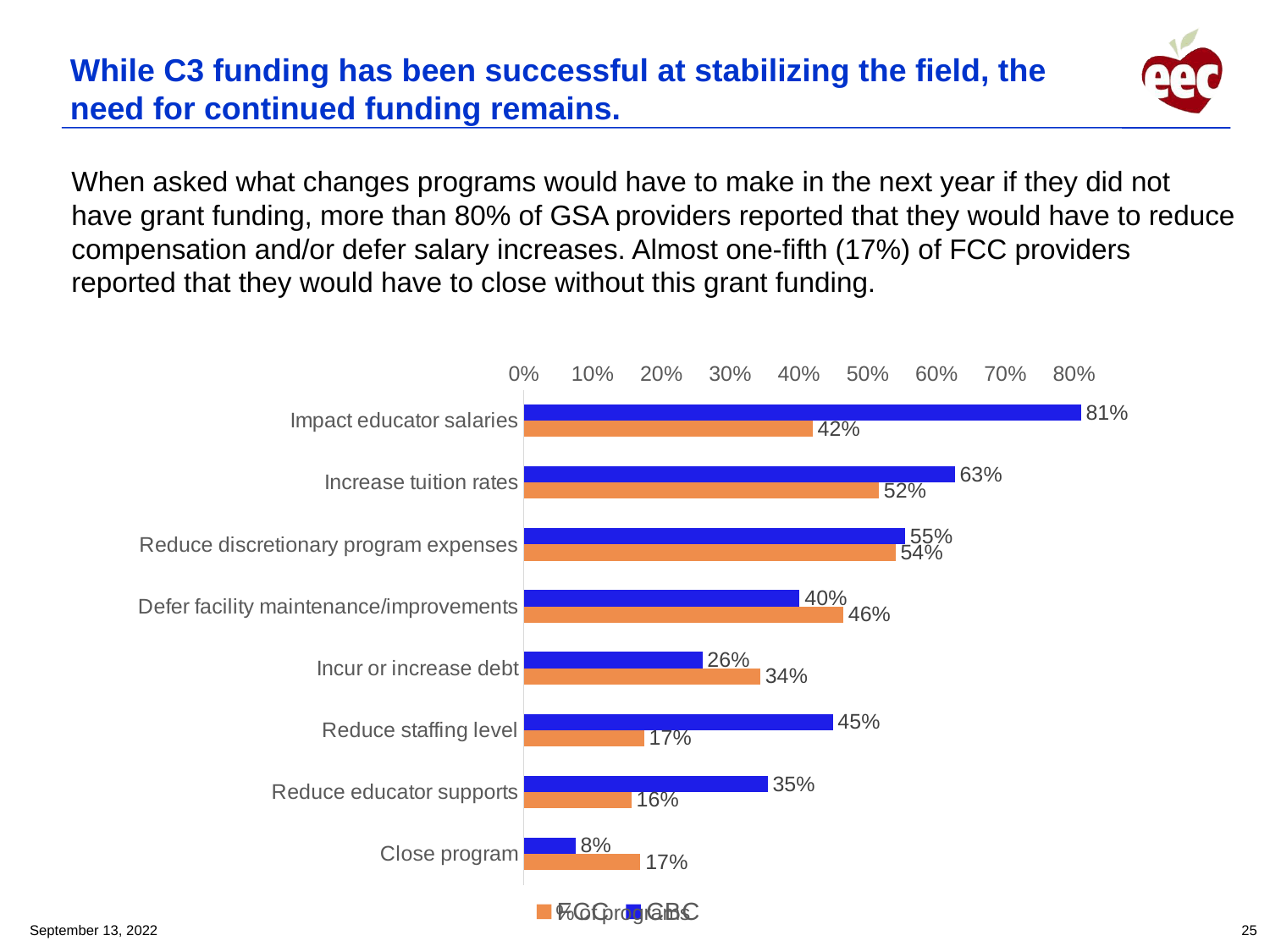
How many series does the chart's legend list? 2 Which category has the highest blue bar value? Impact educator salaries What is the difference between the blue and orange bars for 'Impact educator salaries'? 39% Which category has the highest orange bar value? Reduce discretionary program expenses What is the value of the blue bar for 'Impact educator salaries'? 81% What is the value of the orange bar for 'Close program'? 17% Which category has the lowest blue bar value? Close program What is the value of the orange bar for 'Increase tuition rates'? 52% For 'Defer facility maintenance/improvements', which bar is larger, blue or orange? orange How many categories are shown on the chart? 8 What type of chart is shown on the slide? bar chart What is the difference between the blue and orange bars for 'Reduce staffing level'? 28%